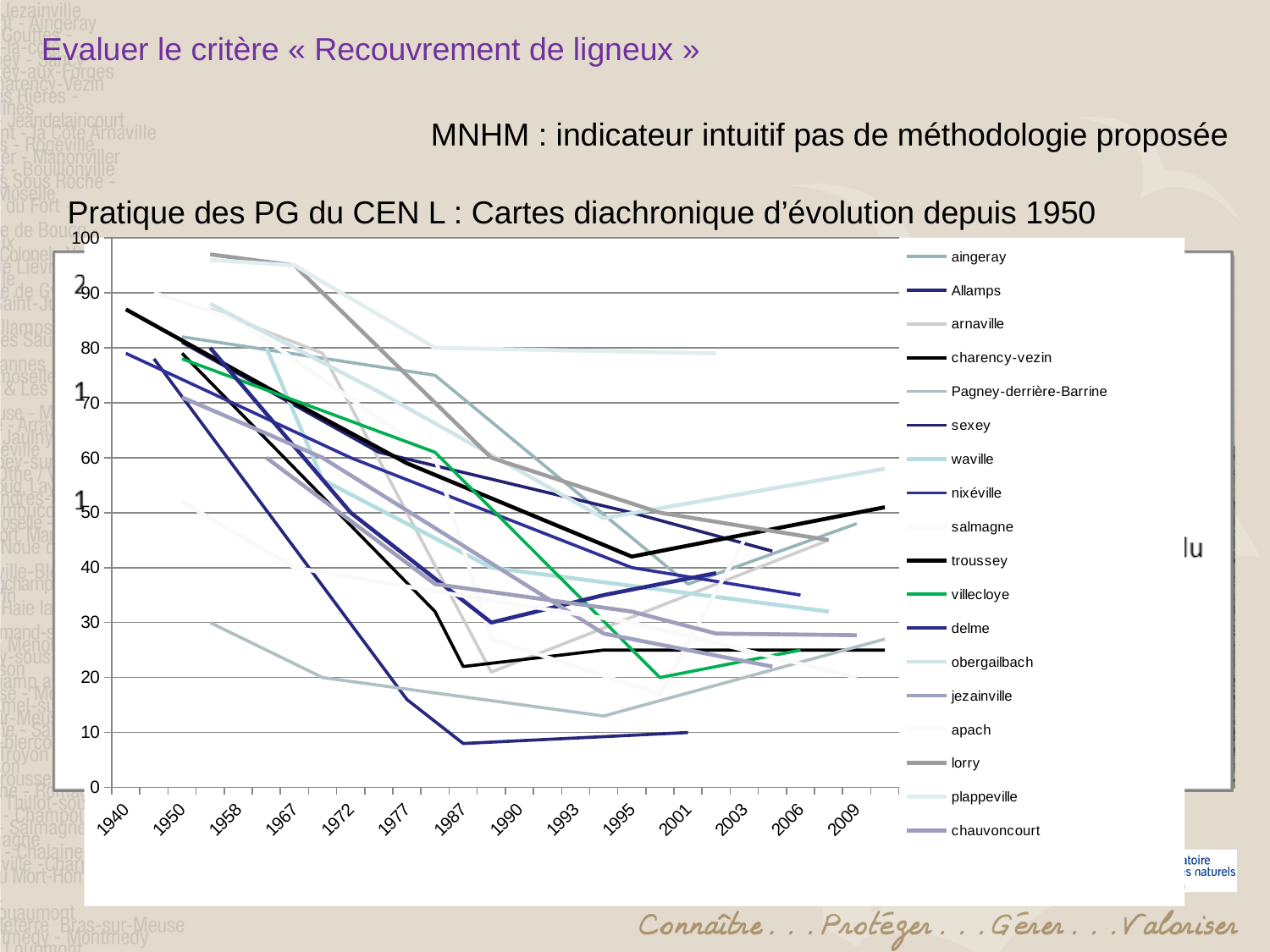
Overall, do the lines in the chart rise or fall between 1940 and 1987? fall Is the value for lorry in 1958 greater or less than 90? greater How many series does the legend of the chart list? 18 What is the first year shown on the x axis of the chart? 1940 How many year labels are shown along the x axis of the chart? 14 What is the last year shown on the x axis of the chart? 2009 What kind of chart is shown on the slide? line chart What is the maximum value shown on the y axis of the chart? 100 Is the value for troussey in 1987 greater or less than 30? greater